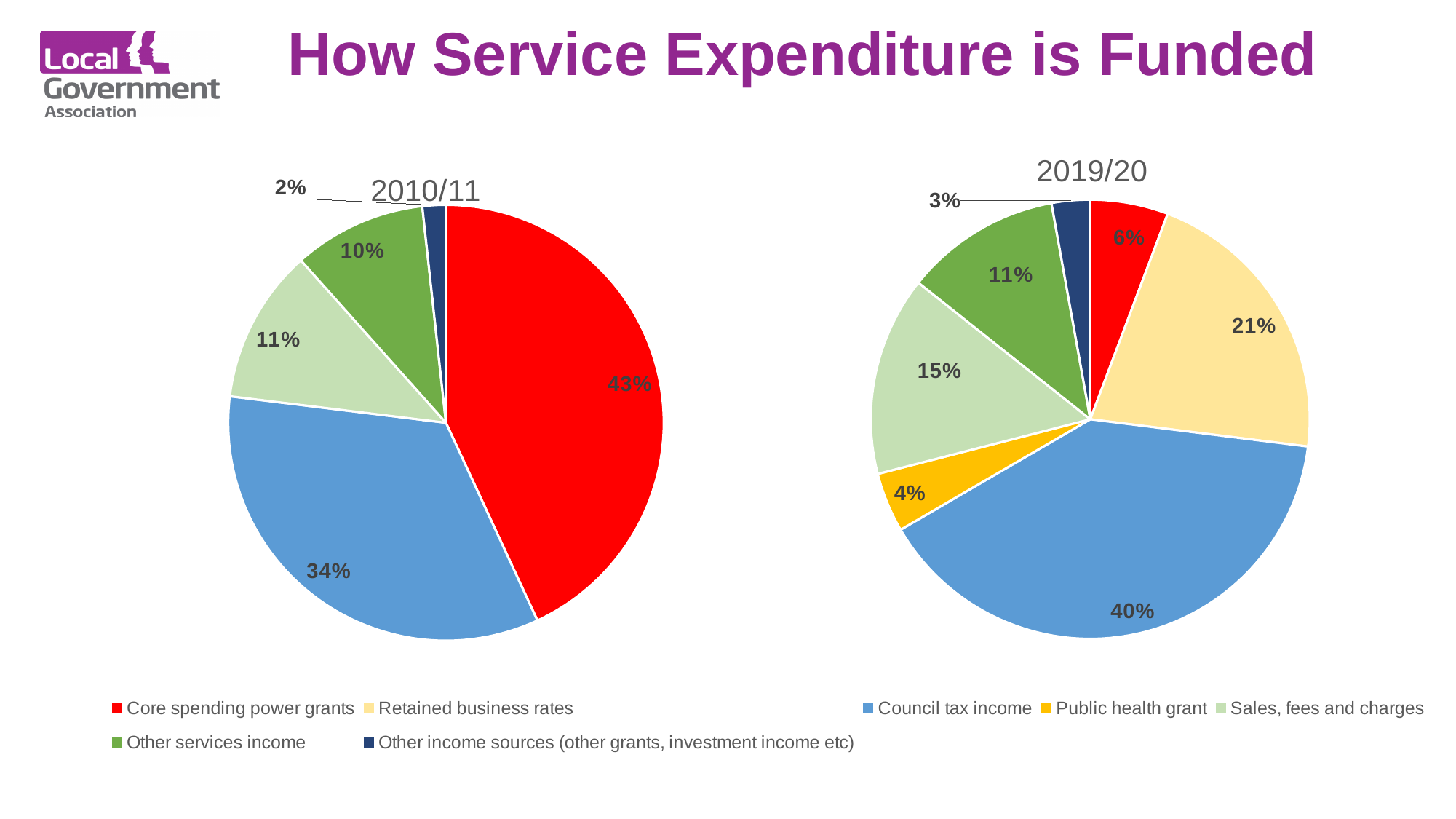
In the 2010/11 pie chart, which category has the largest share? Core spending power grants In the 2019/20 pie chart, which category has the largest share? Council tax income In the 2019/20 pie chart, which is larger: Sales, fees and charges or Other services income? Sales, fees and charges In the 2010/11 pie chart, what share is Core spending power grants? 43% How many slices does the 2019/20 pie chart have? 7 What is the difference between the Core spending power grants share in 2010/11 and in 2019/20? 37 percentage points In the 2019/20 pie chart, what share is Public health grant? 4% In the 2010/11 pie chart, which category has the smallest share? Other income sources (other grants, investment income etc) What type of chart is used on this slide? Pie chart How many slices does the 2010/11 pie chart have? 5 In the 2019/20 pie chart, what share is Council tax income? 40% In the 2019/20 pie chart, what share is Retained business rates? 21%